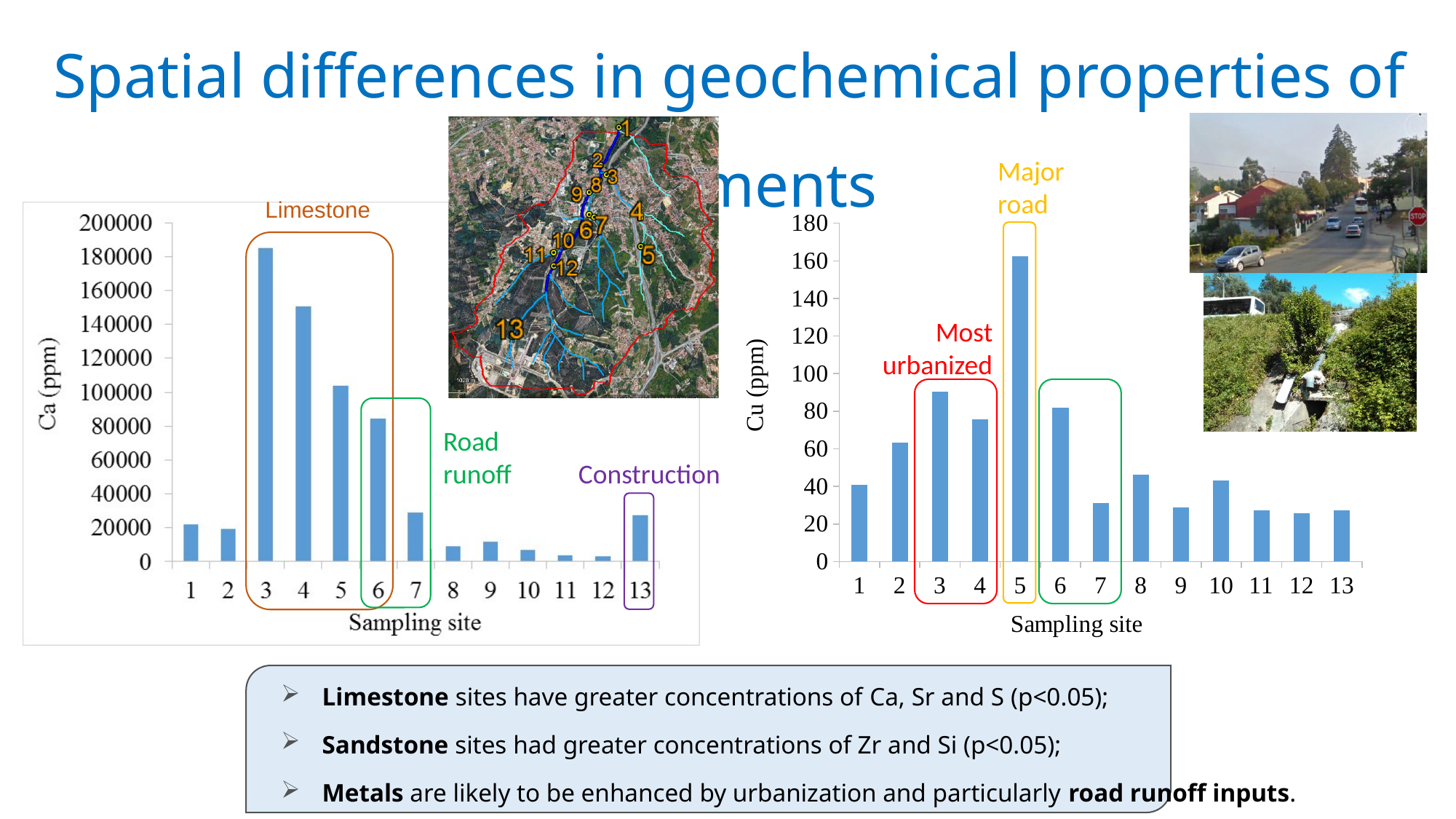
What kind of chart is the Ca (ppm) chart on the left of the slide? bar chart In the Cu (ppm) chart on the right, is the value for sampling site 7 greater or less than 40? less In the Ca (ppm) chart on the left, is the value for sampling site 7 greater or less than 20000? greater In the Ca (ppm) chart on the left, which has the larger value, sampling site 3 or sampling site 4? 3 In the Cu (ppm) chart on the right, is the value for sampling site 5 greater or less than 140? greater In the Cu (ppm) chart on the right, which sampling site has the highest value? 5 In the Cu (ppm) chart on the right, which has the larger value, sampling site 2 or sampling site 8? 2 In the Ca (ppm) chart on the left, which sampling site has the highest value? 3 How many sampling sites are shown on the x axis of the Cu (ppm) chart on the right? 13 In the Cu (ppm) chart on the right, which sampling site is annotated as 'Major road'? 5